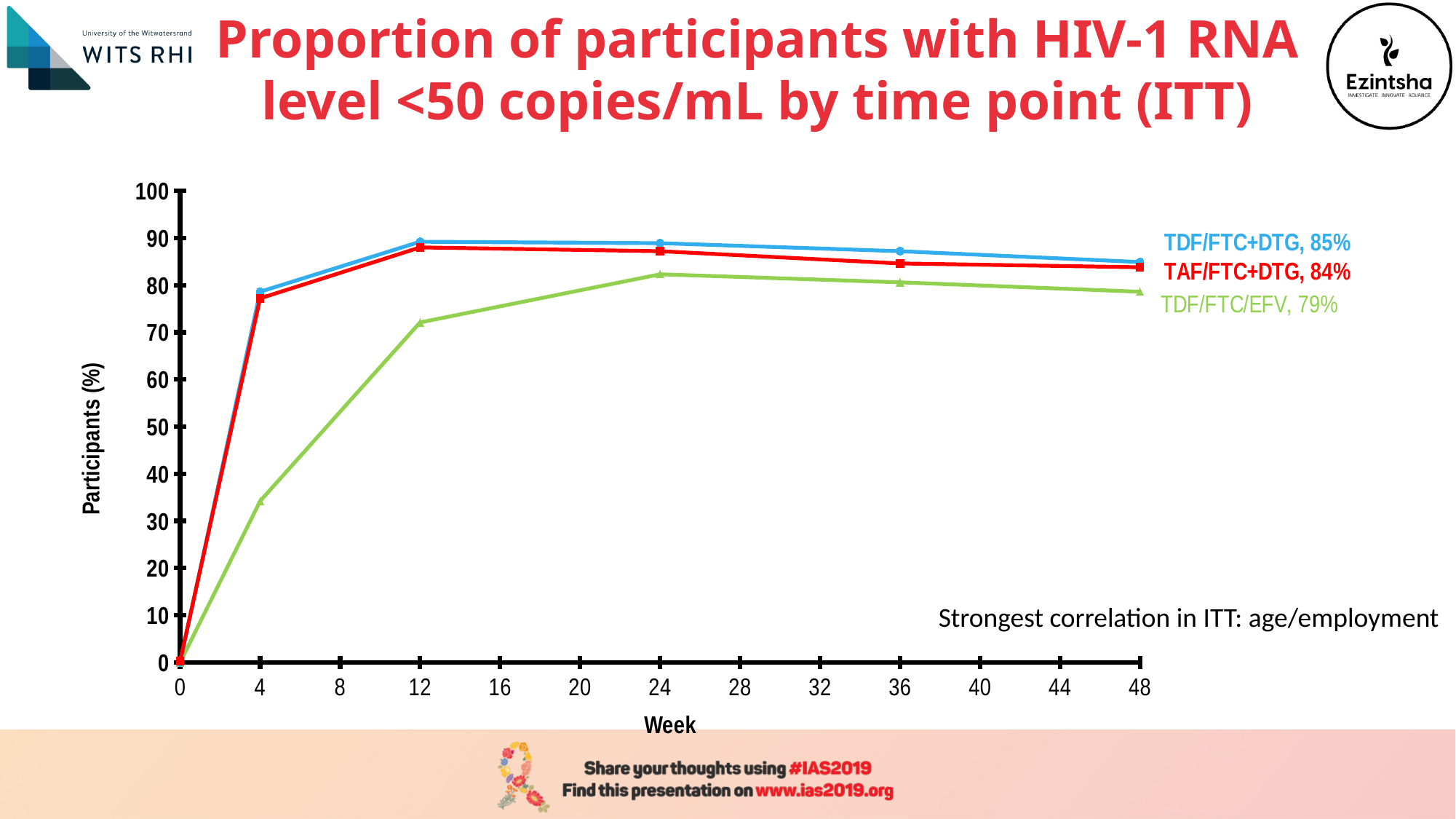
Does the TDF/FTC/EFV line rise or fall between week 0 and week 24? rise Which series has the highest value at week 48? TDF/FTC+DTG How many series (treatment arms) are plotted on the chart? 3 What is the label on the y axis of the chart? Participants (%) What is the value for TAF/FTC+DTG at week 48? 84% What is the value for TDF/FTC+DTG at week 48? 85% What is the difference between the week 48 values for TDF/FTC+DTG and TDF/FTC/EFV? 6% Which series has the lowest value at week 48? TDF/FTC/EFV What is the value for TDF/FTC/EFV at week 48? 79% At week 4, which is higher: TDF/FTC/EFV or TAF/FTC+DTG? TAF/FTC+DTG Is the value for TDF/FTC/EFV at week 4 greater or less than 40? less What kind of chart is shown on the slide? line chart